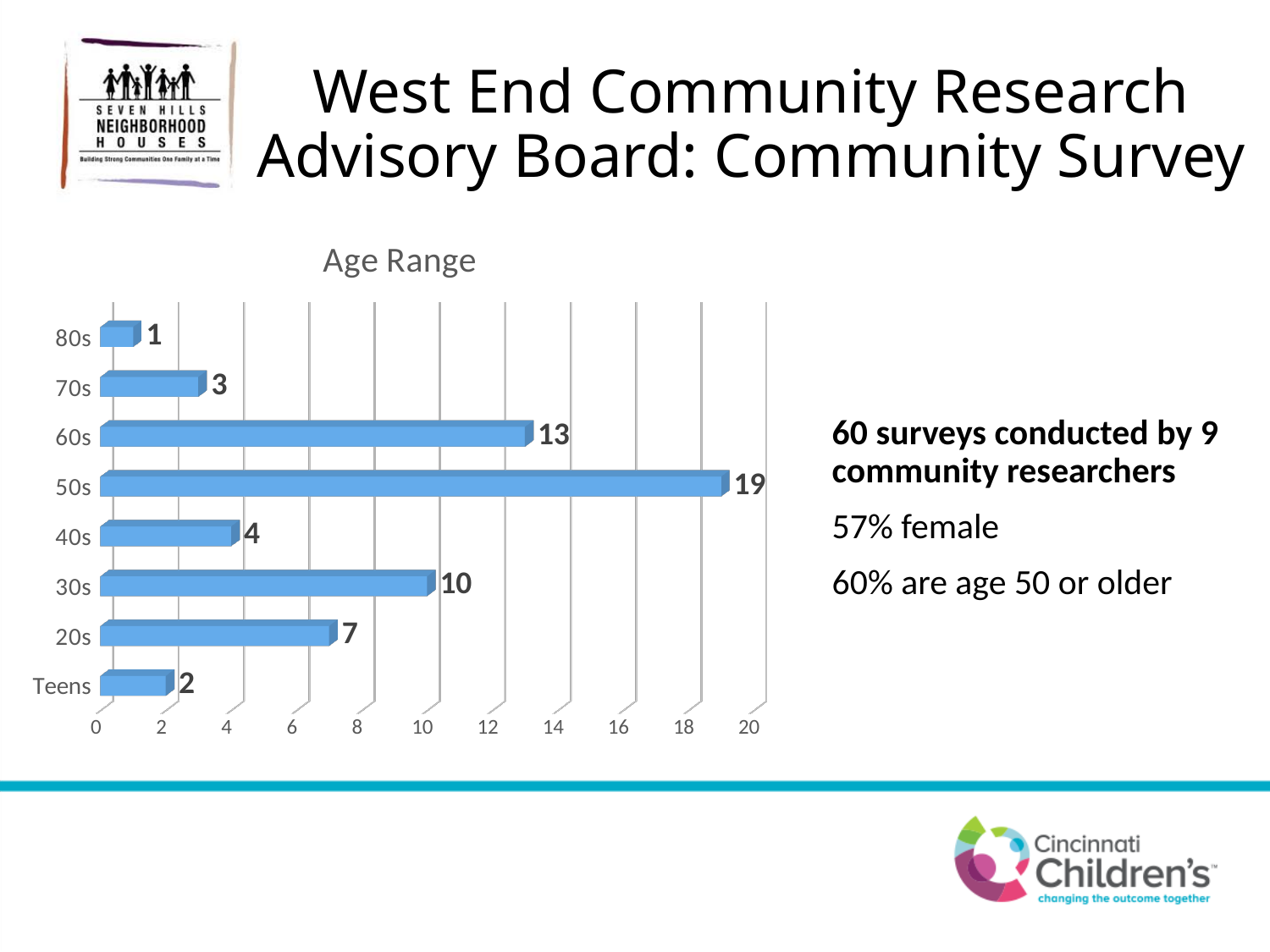
What is the title of the chart? Age Range Which age range has the lowest value? 80s What is the value for Teens? 2 What is the difference between the values for the 50s and the 60s? 6 What kind of chart is shown on the slide? Bar chart How many age range categories are shown in the chart? 8 Which is larger, the value for the 20s or the value for the 40s? 20s Is the value for the 60s greater or less than 10? greater What is the value for the 50s age range? 19 Which age range has the highest value? 50s What is the total of the values for the 70s and 80s? 4 What is the value for the 30s age range? 10